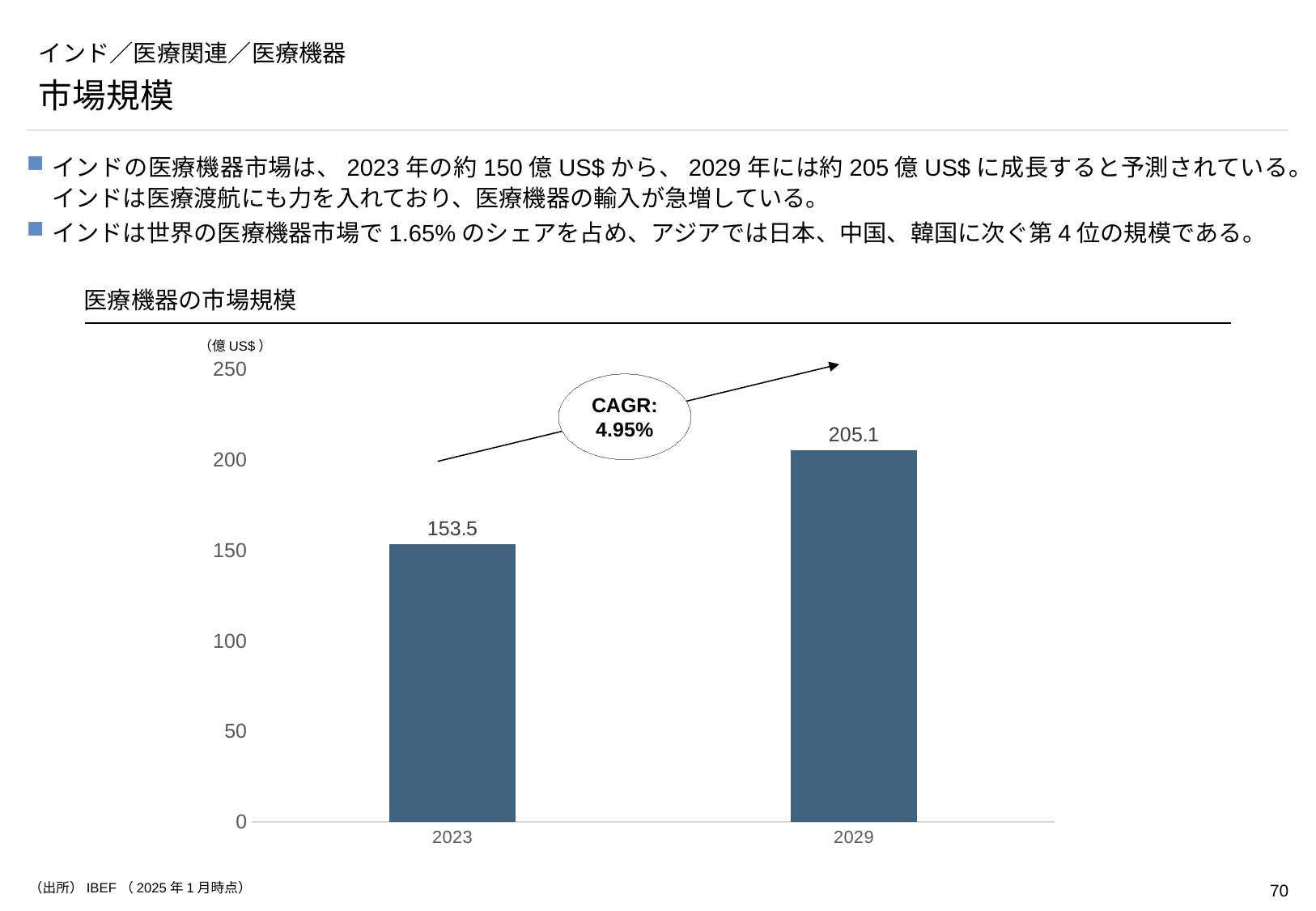
What is the difference between the 2029 value and the 2023 value? 51.6 What is the value for 2023 in the 医療機器の市場規模 chart? 153.5 Which year has the higher value in the chart? 2029 What unit is shown on the chart's vertical axis? 億 US$ What CAGR is annotated on the chart? 4.95% How many bars are shown in the chart? 2 Which year has the lower value in the chart? 2023 Is the value for 2029 greater or less than 200? greater What is the value for 2029 in the 医療機器の市場規模 chart? 205.1 Do the values rise or fall from 2023 to 2029? rise Is the value for 2023 larger or smaller than the value for 2029? smaller What kind of chart is shown on the slide? bar chart